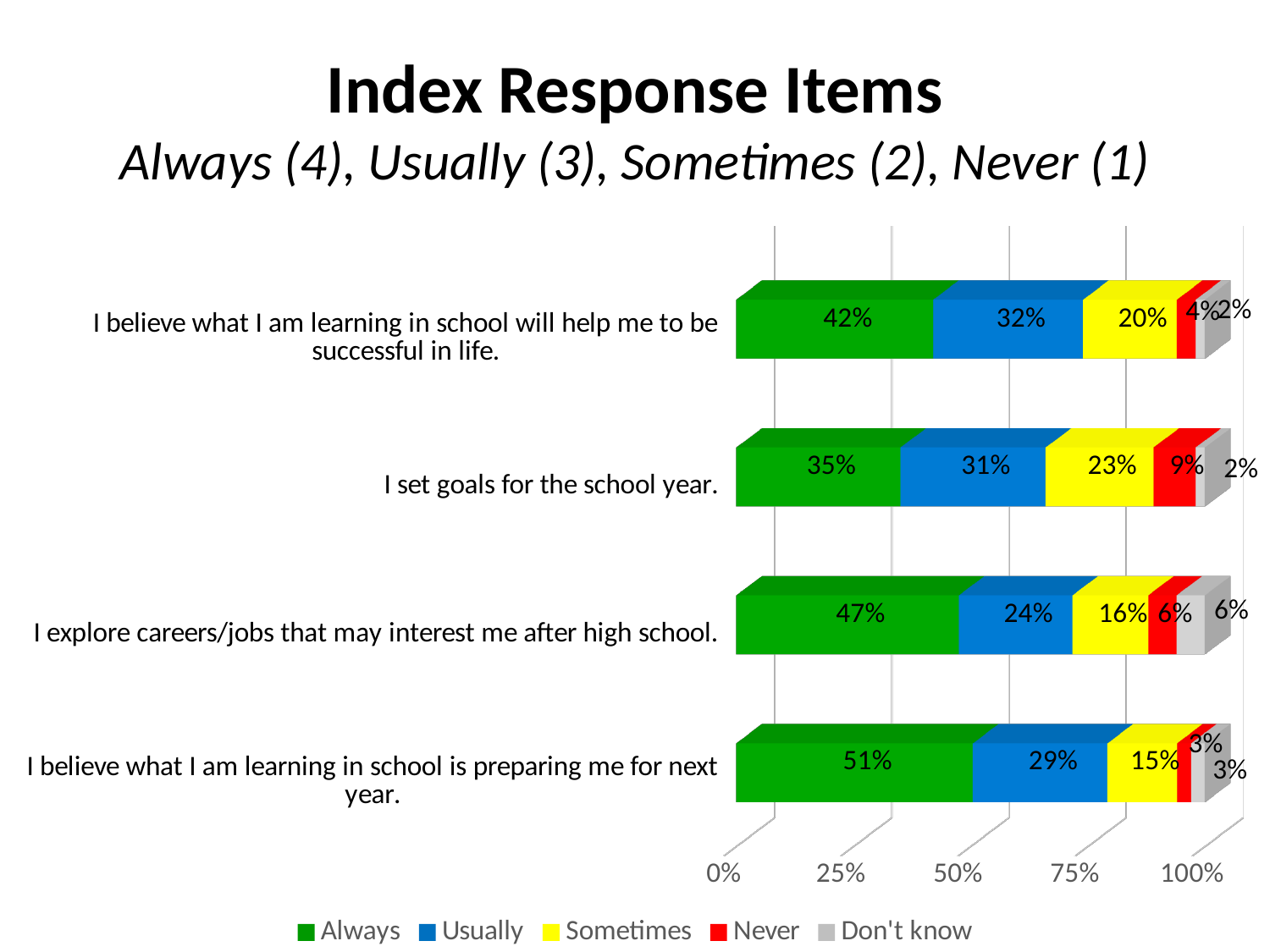
Which item has the highest Always percentage? I believe what I am learning in school is preparing me for next year. Which item has the lowest Always percentage? I set goals for the school year. What is the Sometimes value for "I explore careers/jobs that may interest me after high school."? 16% Which item has the highest Never percentage? I set goals for the school year. How many series does the legend list? 5 What is the Never value for "I believe what I am learning in school will help me to be successful in life."? 4% What is the total of the stacked bar for "I set goals for the school year."? 100% How many response items are shown in the chart? 4 What kind of chart is shown on the slide? Stacked bar chart What percentage of respondents answered Always for "I set goals for the school year."? 35% For "I explore careers/jobs that may interest me after high school.", how much larger is the Always value than the Usually value? 23 percentage points Which item has the larger Sometimes value: "I set goals for the school year." or "I believe what I am learning in school is preparing me for next year."? I set goals for the school year.